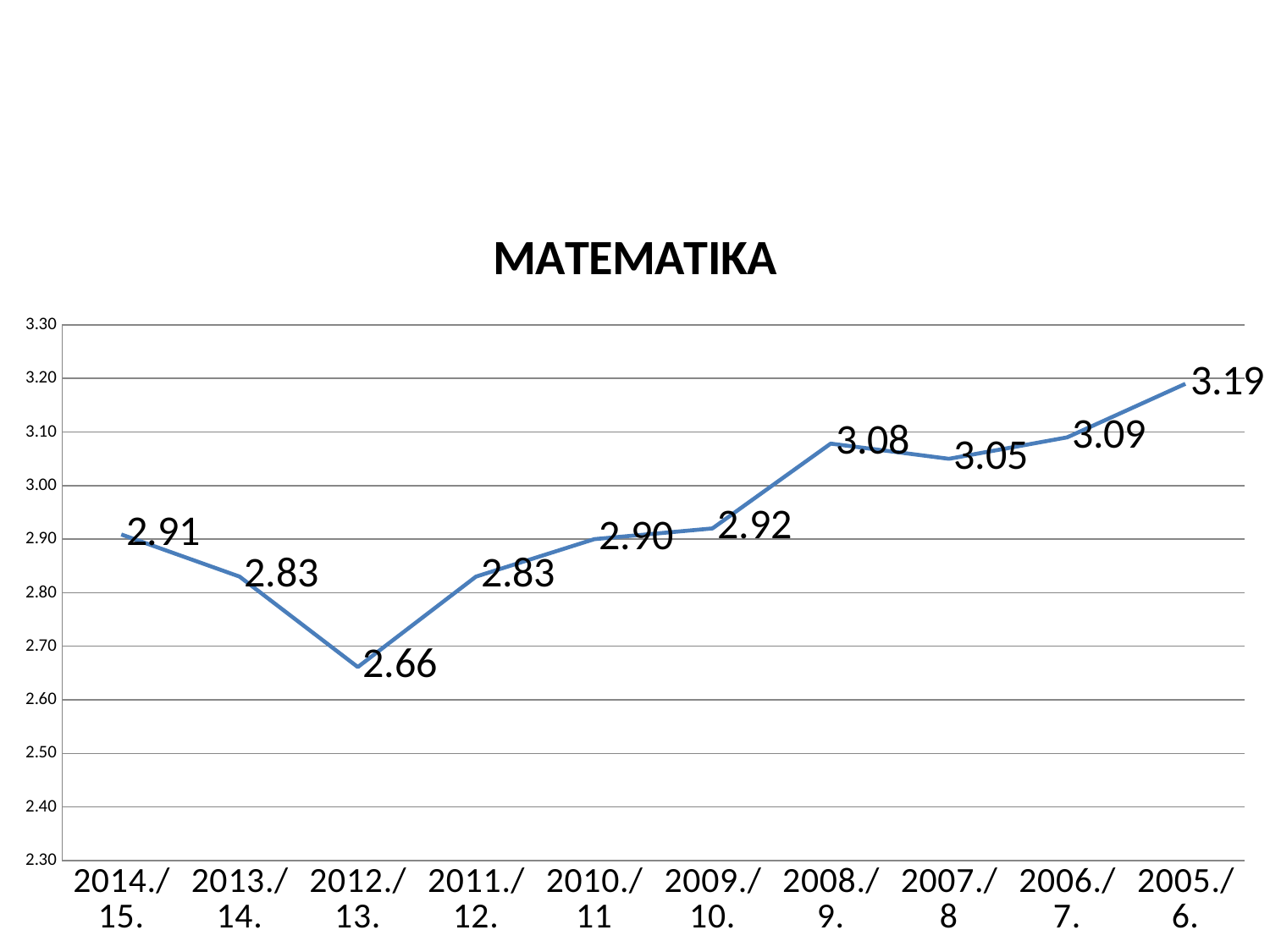
What kind of chart is shown? line chart Which school year has the highest value? 2005./6. Which is larger, the value for 2014./15. or the value for 2013./14.? 2014./15. What is the difference between the values for 2005./6. and 2012./13.? 0.53 Which school year has the lowest value? 2012./13. What is the value for 2005./6.? 3.19 What is the title of the chart? MATEMATIKA Is the value for 2007./8 greater or less than 3.00? greater What is the value for 2008./9.? 3.08 Do the values rise or fall from 2012./13. to 2005./6. along the x axis? rise What is the value for 2012./13.? 2.66 How many school years are plotted on the chart? 10